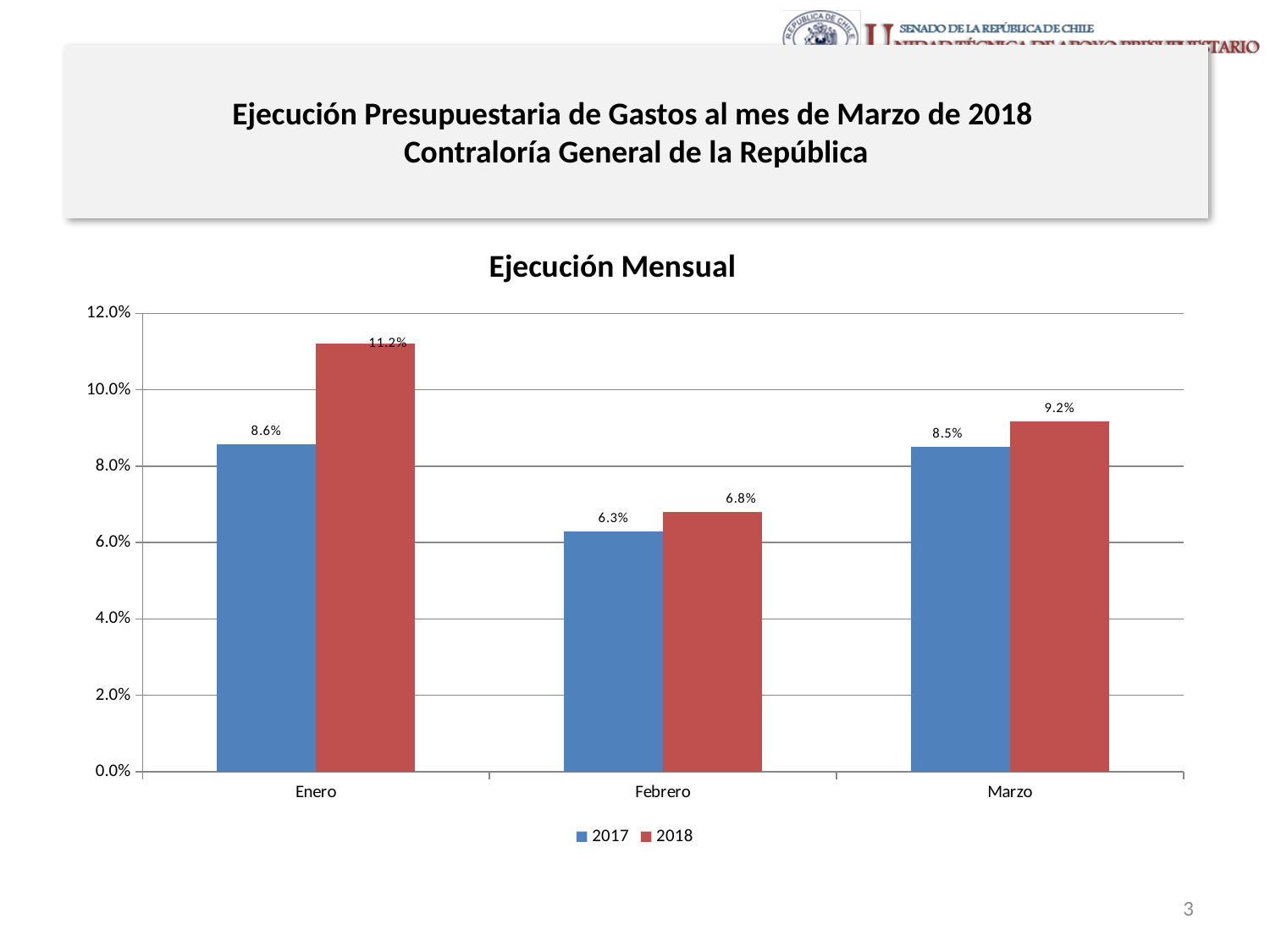
What is the value for 2018 in Enero? 11.2% What type of chart is shown? Bar chart Which month has the highest value for the 2018 series? Enero Is the value for 2017 in Enero greater or less than 8.0%? greater Which is larger in Febrero, the 2017 value or the 2018 value? 2018 How many series does the legend list? 2 What is the value for 2017 in Febrero? 6.3% What is the value for 2017 in Marzo? 8.5% How many months are shown on the x axis? 3 What is the difference between the 2018 and 2017 values in Enero? 2.6% Which month has the lowest value for the 2017 series? Febrero What is the value for 2018 in Marzo? 9.2%